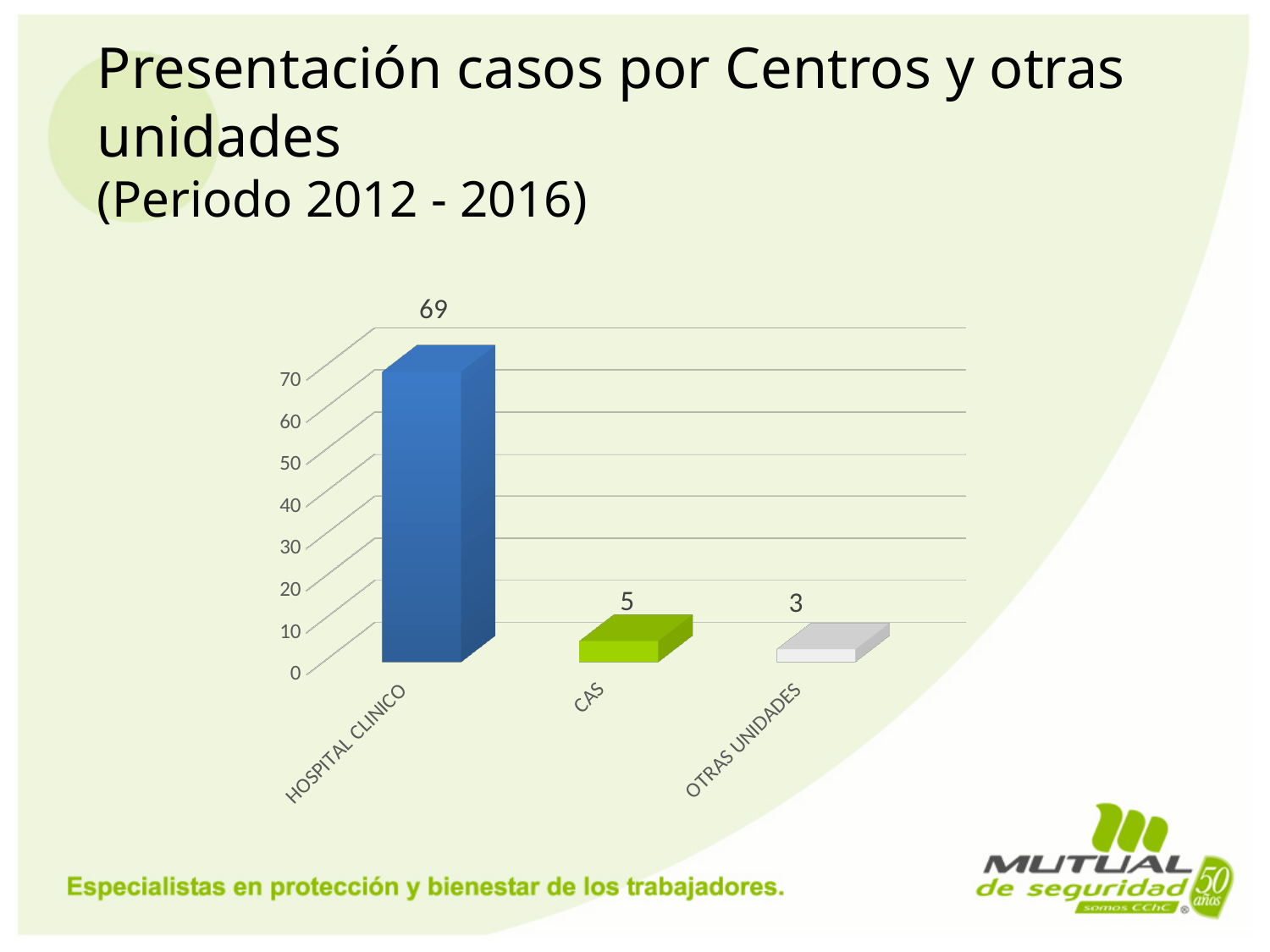
What kind of chart is shown on the slide? bar chart What is the value for OTRAS UNIDADES? 3 Is the value for HOSPITAL CLINICO greater or less than 60? greater What is the difference between the values for CAS and OTRAS UNIDADES? 2 Which category has the highest value? HOSPITAL CLINICO Which is larger, the value for CAS or the value for OTRAS UNIDADES? CAS What is the value for HOSPITAL CLINICO? 69 What is the difference between the values for HOSPITAL CLINICO and CAS? 64 What is the value for CAS? 5 How many categories are shown on the x axis? 3 What colour is the bar for HOSPITAL CLINICO? blue Which category has the lowest value? OTRAS UNIDADES